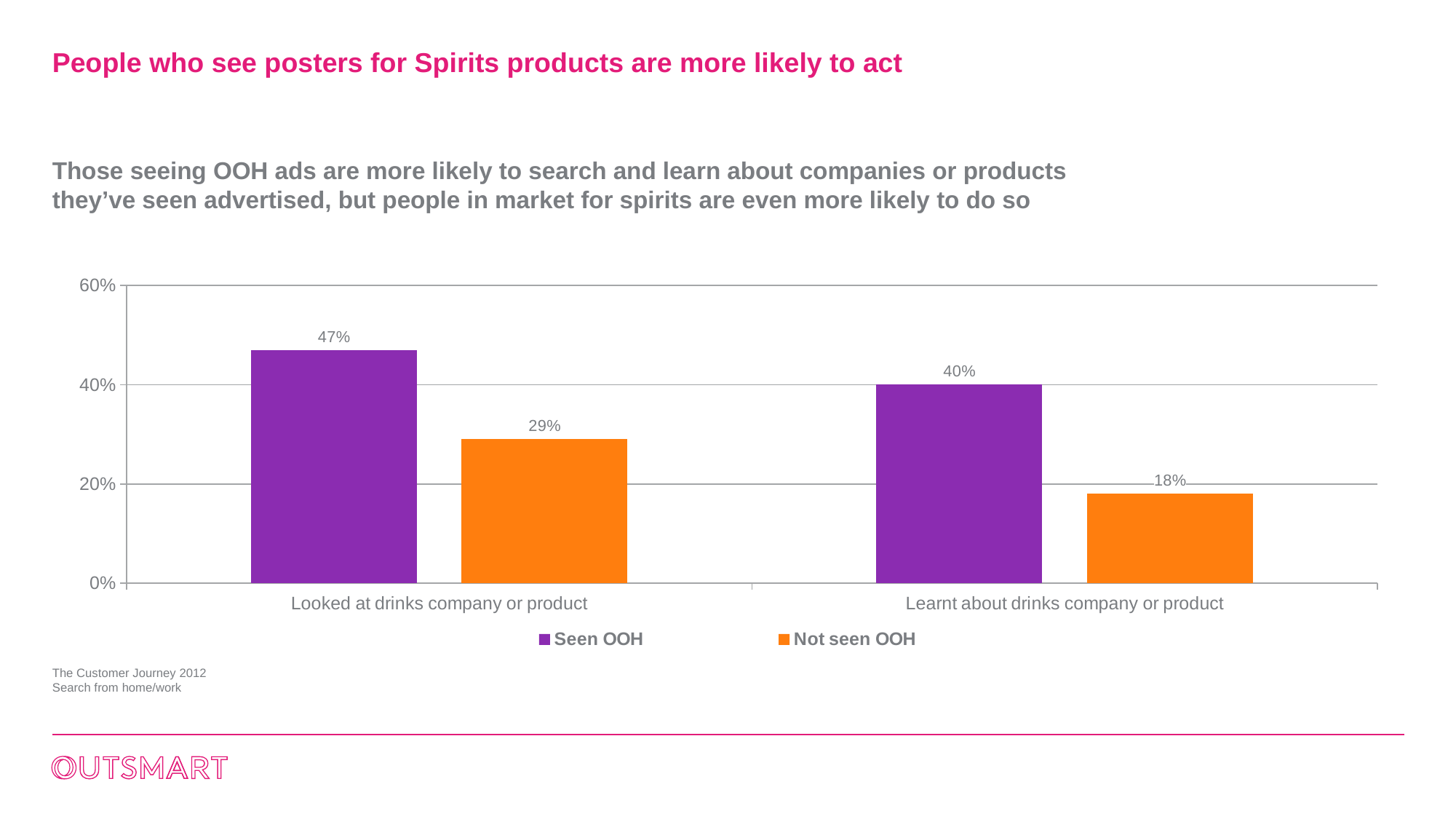
What is the value for Not seen OOH in the 'Looked at drinks company or product' category? 29% What is the value for Not seen OOH in the 'Learnt about drinks company or product' category? 18% Which bar has the lowest value on the chart? Not seen OOH, Learnt about drinks company or product What is the difference between Seen OOH and Not seen OOH for 'Learnt about drinks company or product'? 22% What is the value for Seen OOH in the 'Learnt about drinks company or product' category? 40% What is the value for Seen OOH in the 'Looked at drinks company or product' category? 47% How many series does the legend list? 2 How many categories are shown on the x axis? 2 What is the difference between Seen OOH and Not seen OOH for 'Looked at drinks company or product'? 18% Which is larger for 'Learnt about drinks company or product': Seen OOH or Not seen OOH? Seen OOH Which bar has the highest value on the chart? Seen OOH, Looked at drinks company or product What kind of chart is shown on the slide? Bar chart